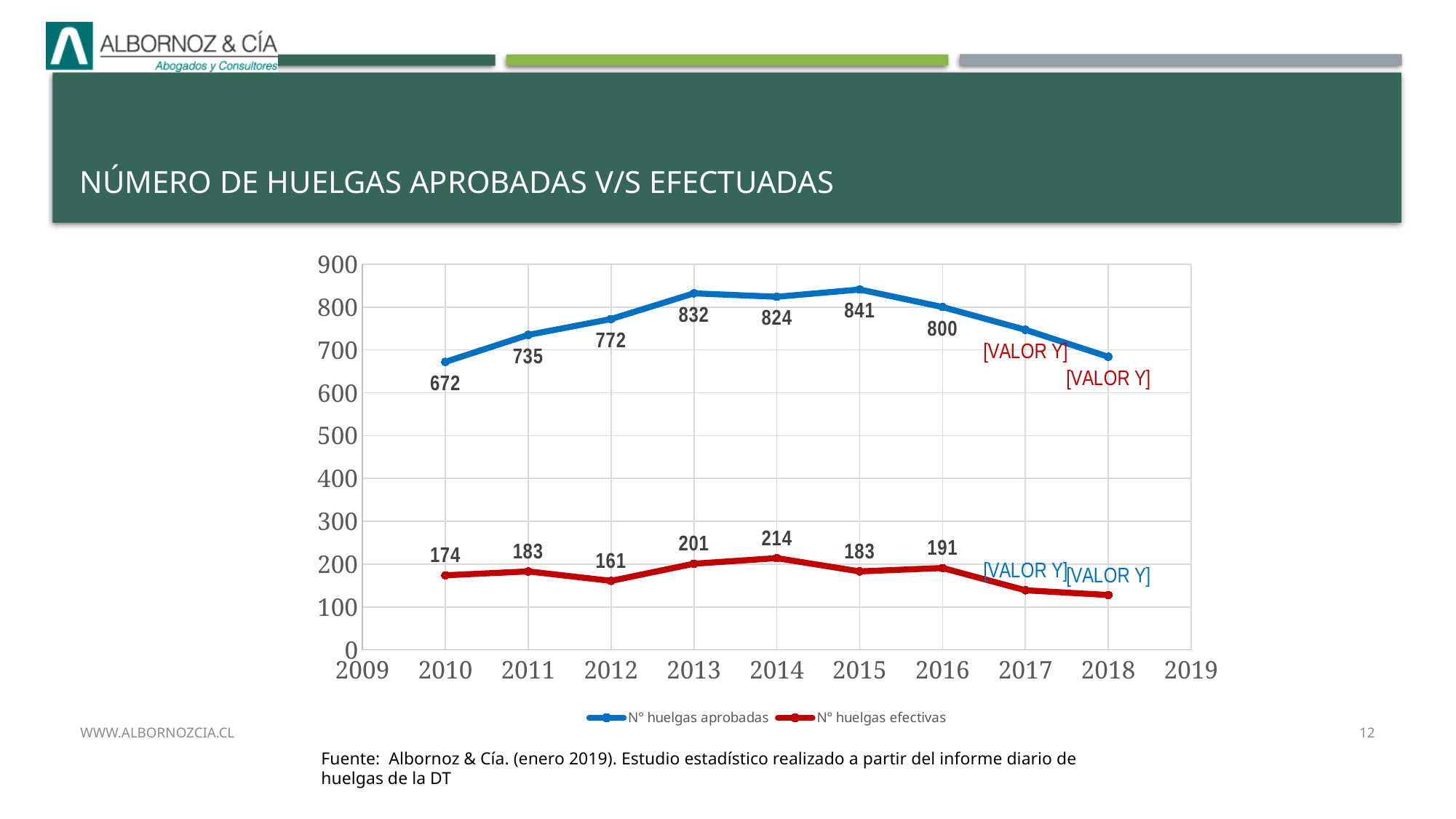
In which year is N° huelgas efectivas lowest? 2018 How many series does the legend list? 2 Is the value for N° huelgas aprobadas in 2017 greater or less than 700? greater How many years are plotted for each series? 9 What is the difference between N° huelgas aprobadas and N° huelgas efectivas in 2014? 610 What is the value of N° huelgas aprobadas in 2010? 672 What is the value of N° huelgas aprobadas in 2016? 800 Which is larger: N° huelgas efectivas in 2011 or in 2012? 2011 In which year is N° huelgas efectivas highest? 2014 What type of chart is shown on the slide? Line chart What is the value of N° huelgas efectivas in 2014? 214 In which year is N° huelgas aprobadas highest? 2015